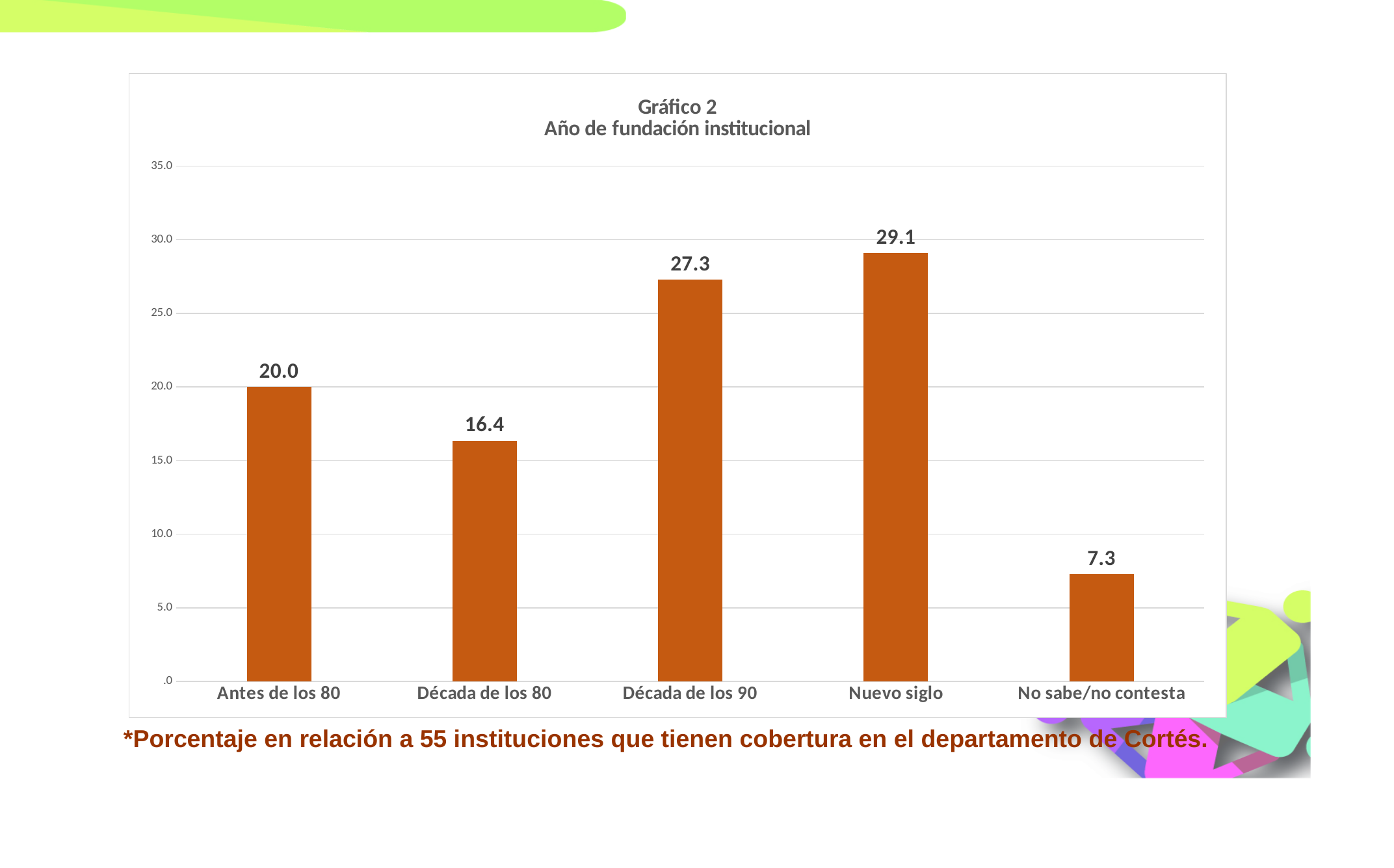
What is the value for No sabe/no contesta? 7.3 Which category has the lowest value? No sabe/no contesta How many categories are shown on the x axis? 5 What is the difference between the values for Década de los 90 and No sabe/no contesta? 20.0 Is the value for Década de los 90 greater or less than 25.0? greater What kind of chart is shown on the slide? bar chart Which category has the highest value? Nuevo siglo Which is larger, the value for Antes de los 80 or the value for Década de los 80? Antes de los 80 What is the value for Década de los 90? 27.3 What is the title of the chart? Gráfico 2 Año de fundación institucional What is the value for Antes de los 80? 20.0 What is the difference between the values for Nuevo siglo and Década de los 80? 12.7